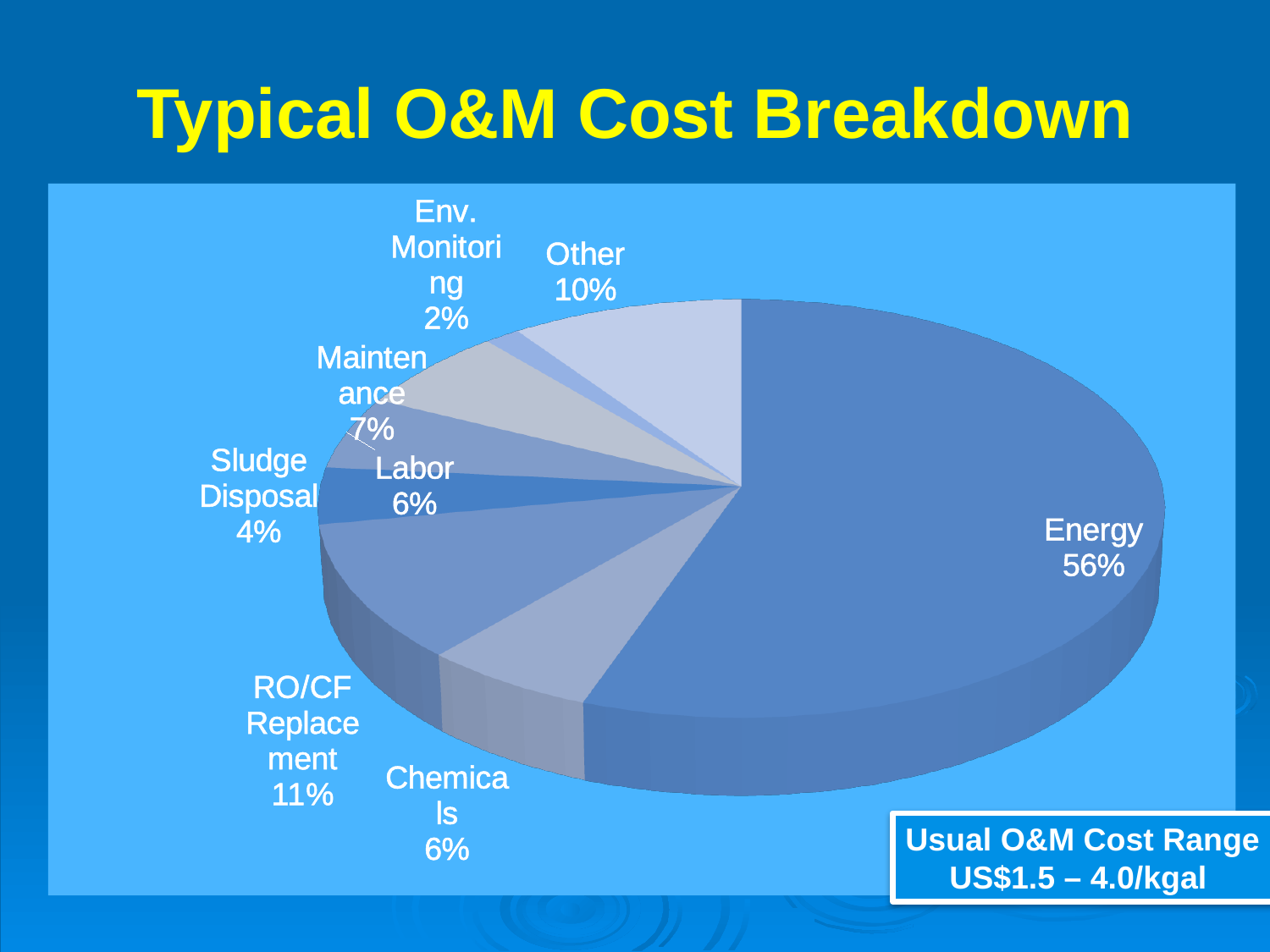
What is the title of the slide? Typical O&M Cost Breakdown What is the difference between the Energy share and the Other share? 46% What is the value shown for Env. Monitoring? 2% Which category has the largest share of the pie? Energy How many categories are shown in the pie chart? 8 Which category has the smallest share of the pie? Env. Monitoring What is the value shown for RO/CF Replacement? 11% What is the value shown for Maintenance? 7% What kind of chart is shown on the slide? Pie chart Which is larger, the share for Sludge Disposal or the share for Maintenance? Maintenance What usual O&M cost range is stated in the box on the slide? US$1.5 – 4.0/kgal What share of the pie does Energy account for? 56%